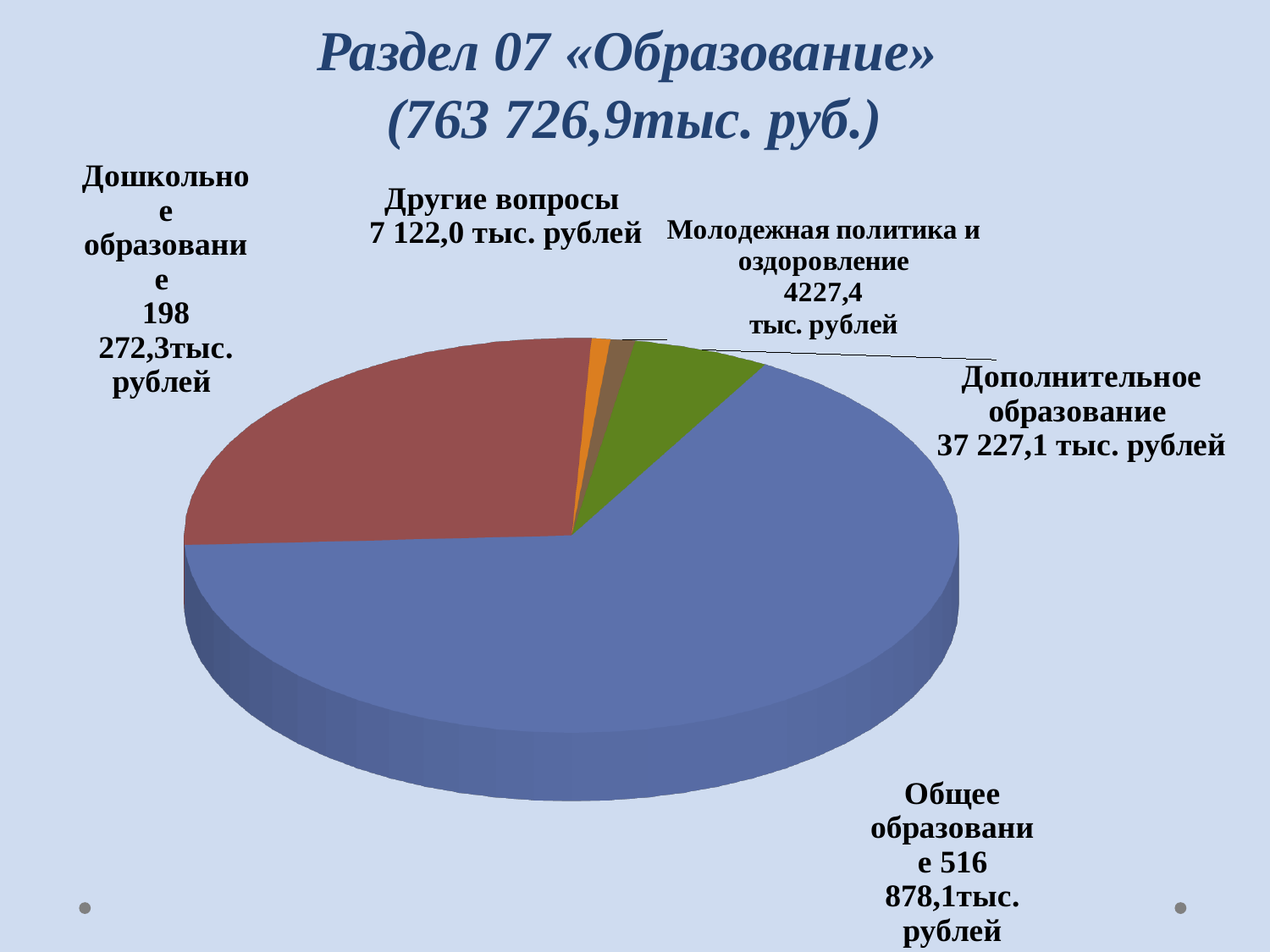
How many categories are shown in the pie chart? 5 Which is larger, Дополнительное образование or Другие вопросы? Дополнительное образование What is the value for Другие вопросы? 7 122,0 тыс. рублей What is the value for Общее образование? 516 878,1 тыс. рублей What is the value for Молодежная политика и оздоровление? 4227,4 тыс. рублей What type of chart is shown on the slide? Pie chart What is the value for Дополнительное образование? 37 227,1 тыс. рублей What total amount is given in the chart title for Раздел 07 «Образование»? 763 726,9 тыс. руб. What is the difference between Общее образование and Дошкольное образование? 318 605,8 тыс. рублей Which category has the largest slice of the pie? Общее образование What is the value for Дошкольное образование? 198 272,3 тыс. рублей